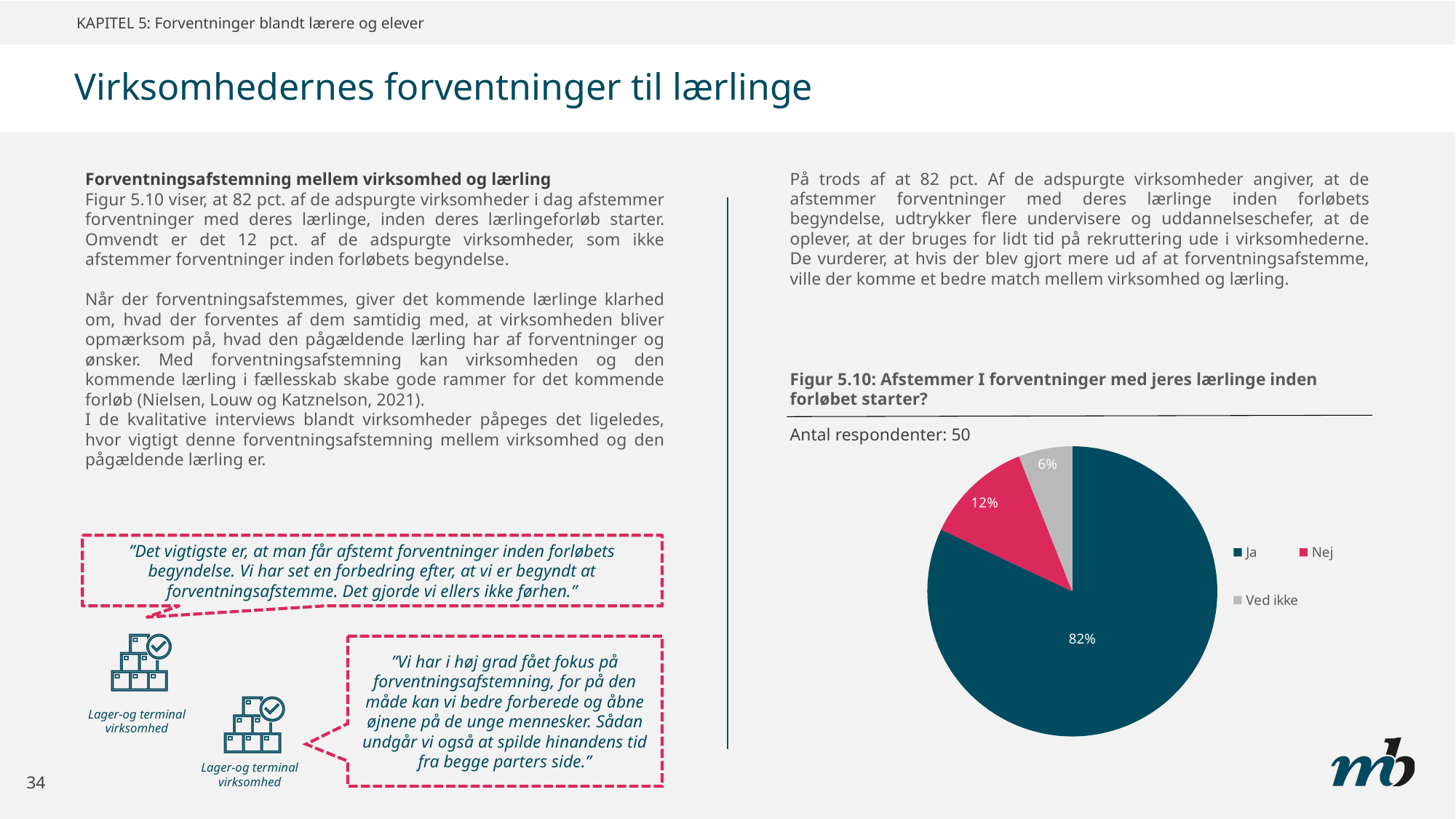
Which category has the smallest slice of the pie? Ved ikke What kind of chart is shown on the slide? Pie chart What share of the pie does "Ved ikke" account for? 6% Which category has the largest slice of the pie? Ja How many respondents does the chart state it is based on? 50 How many categories does the pie chart show? 3 What share of the pie does "Nej" account for? 12% What is the title of the chart? Figur 5.10: Afstemmer I forventninger med jeres lærlinge inden forløbet starter? What is the combined share of the "Nej" and "Ved ikke" slices? 18% What share of the pie does "Ja" account for? 82% What is the difference in percentage points between the "Ja" and "Nej" slices? 70 Which is larger, the "Nej" slice or the "Ved ikke" slice? Nej